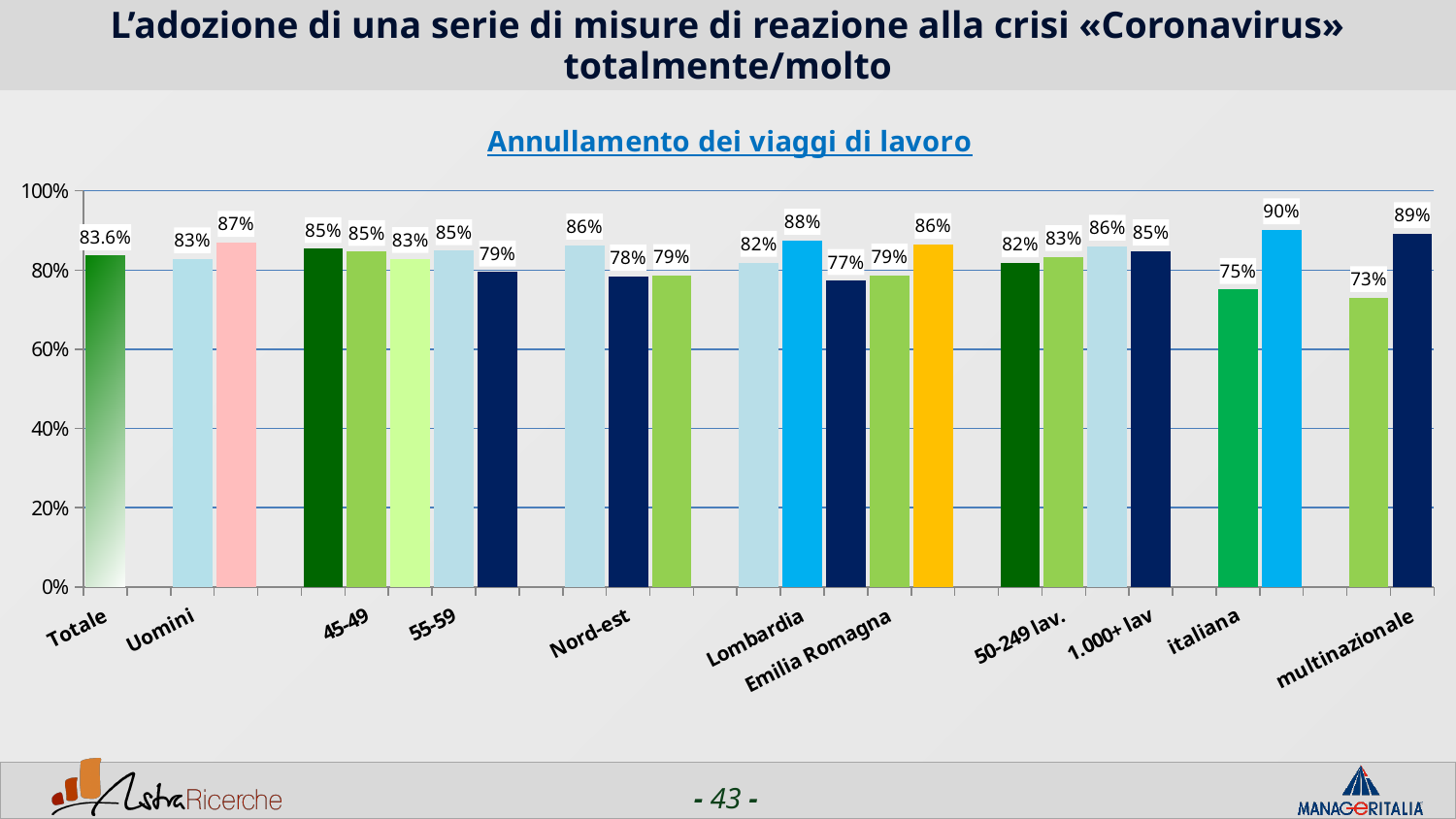
What is the difference between the values for Lombardia and Emilia Romagna? 9 percentage points What is the title of the chart? Annullamento dei viaggi di lavoro What kind of chart is shown on the slide? Bar chart What is the lowest value shown on any bar in the chart? 73% What is the value for Totale? 83.6% Is the value for Totale greater or less than 80%? greater What is the value for multinazionale? 89% What is the value for Emilia Romagna? 79% What is the highest value shown on any bar in the chart? 90% What is the value for Lombardia? 88% Which is larger, the value for Lombardia or the value for Emilia Romagna? Lombardia What is the value for Uomini? 83%